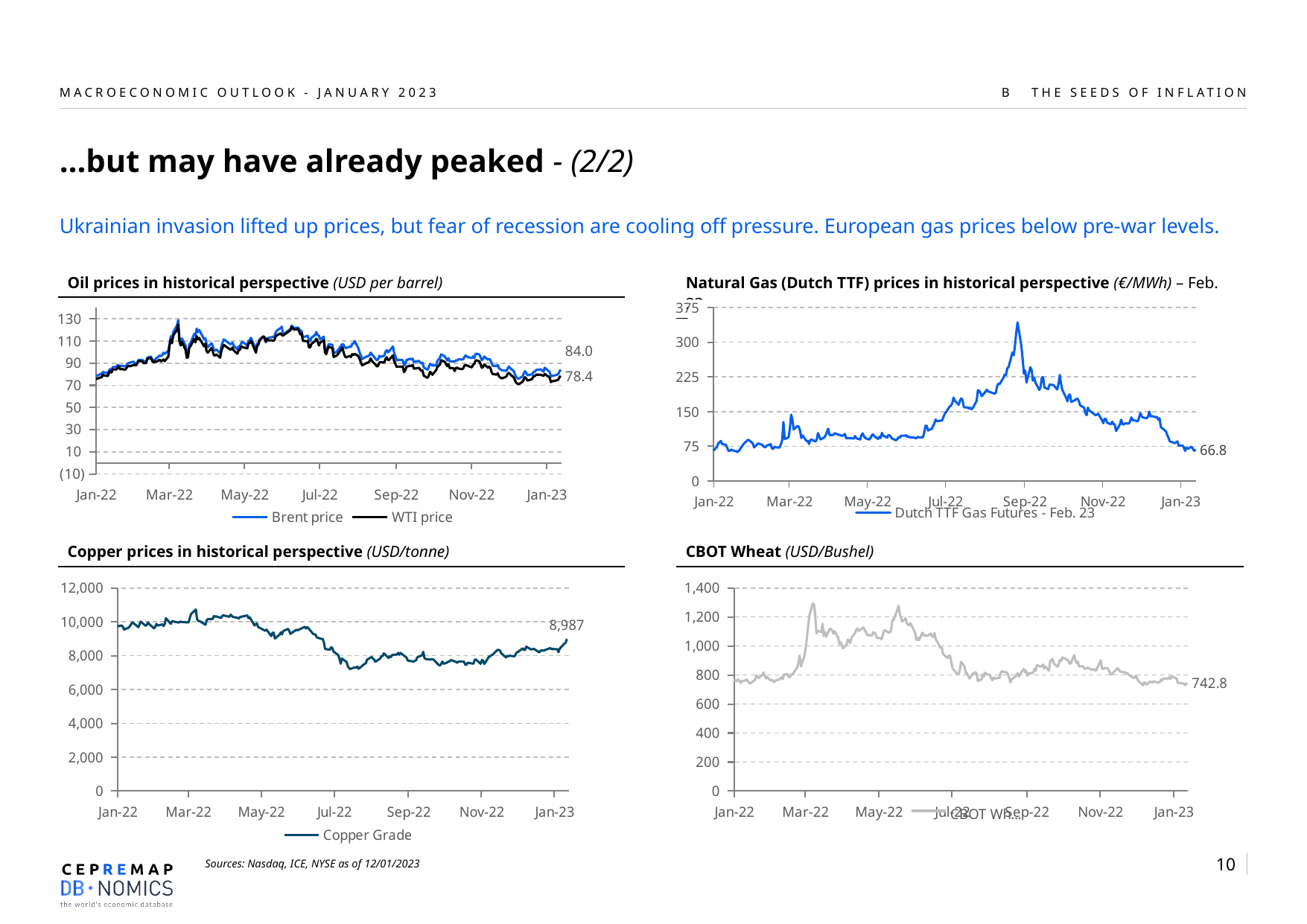
On the 'Oil prices in historical perspective' chart, what is the latest labelled value for the WTI price? 78.4 On the 'Oil prices in historical perspective' chart, which series has the higher latest labelled value, Brent price or WTI price? Brent price On the 'Natural Gas (Dutch TTF) prices in historical perspective' chart, what is the latest labelled value? 66.8 On the 'Oil prices in historical perspective' chart, how many series does the legend list? 2 On the 'Oil prices in historical perspective' chart, what is the latest labelled value for the Brent price? 84.0 On the 'Oil prices in historical perspective' chart, what is the difference between the latest labelled Brent price and WTI price? 5.6 On the 'Copper prices in historical perspective' chart, do copper prices rise or fall between Mar-22 and Jul-22? fall On the 'Copper prices in historical perspective' chart, what is the latest labelled value? 8,987 On the 'CBOT Wheat' chart, is the peak value around May-22 greater or less than 1,200? greater On the 'CBOT Wheat' chart, what is the latest labelled value? 742.8 On the 'Natural Gas (Dutch TTF) prices in historical perspective' chart, is the peak value around Aug-22 greater or less than 300? greater What kind of chart is the 'Copper prices in historical perspective' chart? line chart